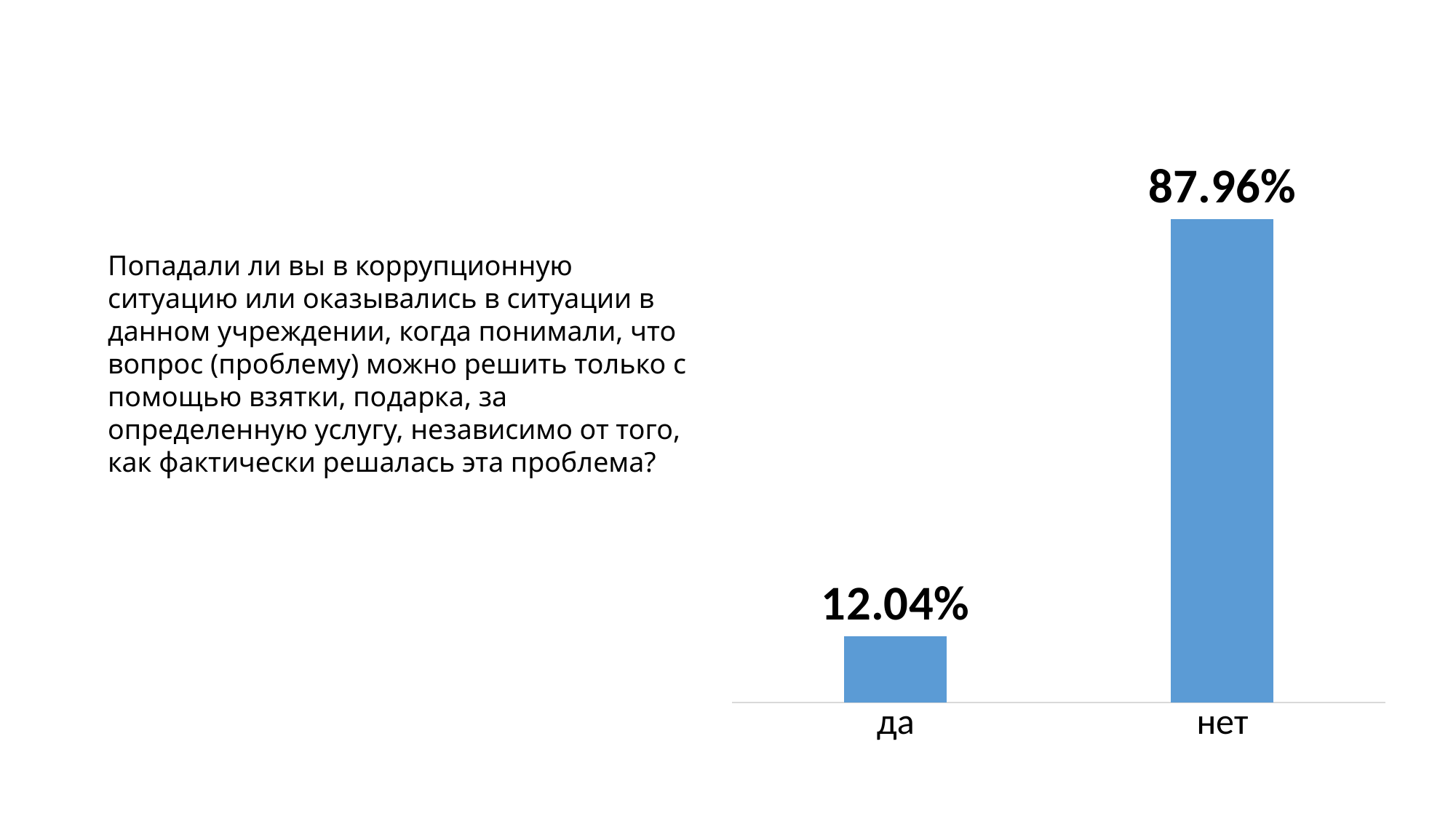
Which category has the lowest value? да What kind of chart is shown on the slide? bar chart How many categories are shown on the x axis? 2 What colour are the bars in the chart? blue Which is larger, the value for "да" or the value for "нет"? нет What is the value for "да"? 12.04% What is the value for "нет"? 87.96% What is the difference between the values for "нет" and "да"? 75.92% Which category has the highest value? нет What is the total of the two values shown in the chart? 100% Do the values rise or fall from "да" to "нет" along the x axis? rise